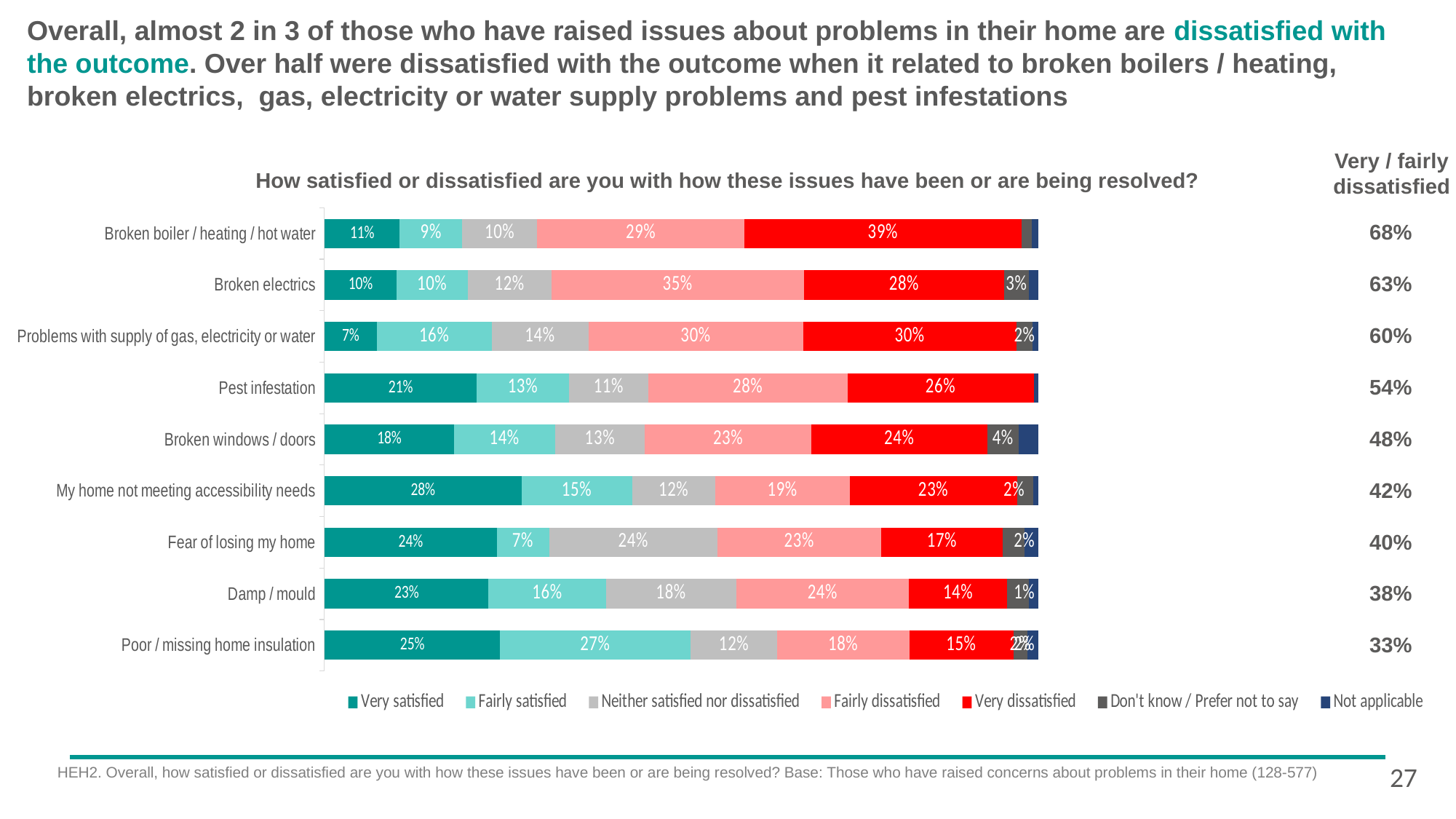
Which has a larger 'Fairly dissatisfied' percentage: broken electrics or pest infestation? Broken electrics Which issue has the lowest 'Very satisfied' percentage? Problems with supply of gas, electricity or water What percentage of respondents with damp / mould issues were very satisfied? 23% What type of chart is shown on the slide? Stacked bar chart How many issue categories are shown in the chart? 9 What percentage of respondents with broken electrics were fairly dissatisfied? 35% How many series does the legend list? 7 What is the difference in the 'Very dissatisfied' percentage between broken boiler / heating / hot water and damp / mould? 25 percentage points Which issue has the highest 'Very satisfied' percentage? My home not meeting accessibility needs Which issue has the highest 'Very dissatisfied' percentage? Broken boiler / heating / hot water What is the 'Very / fairly dissatisfied' percentage shown for poor / missing home insulation? 33% What percentage of respondents with a broken boiler / heating / hot water issue were very dissatisfied? 39%